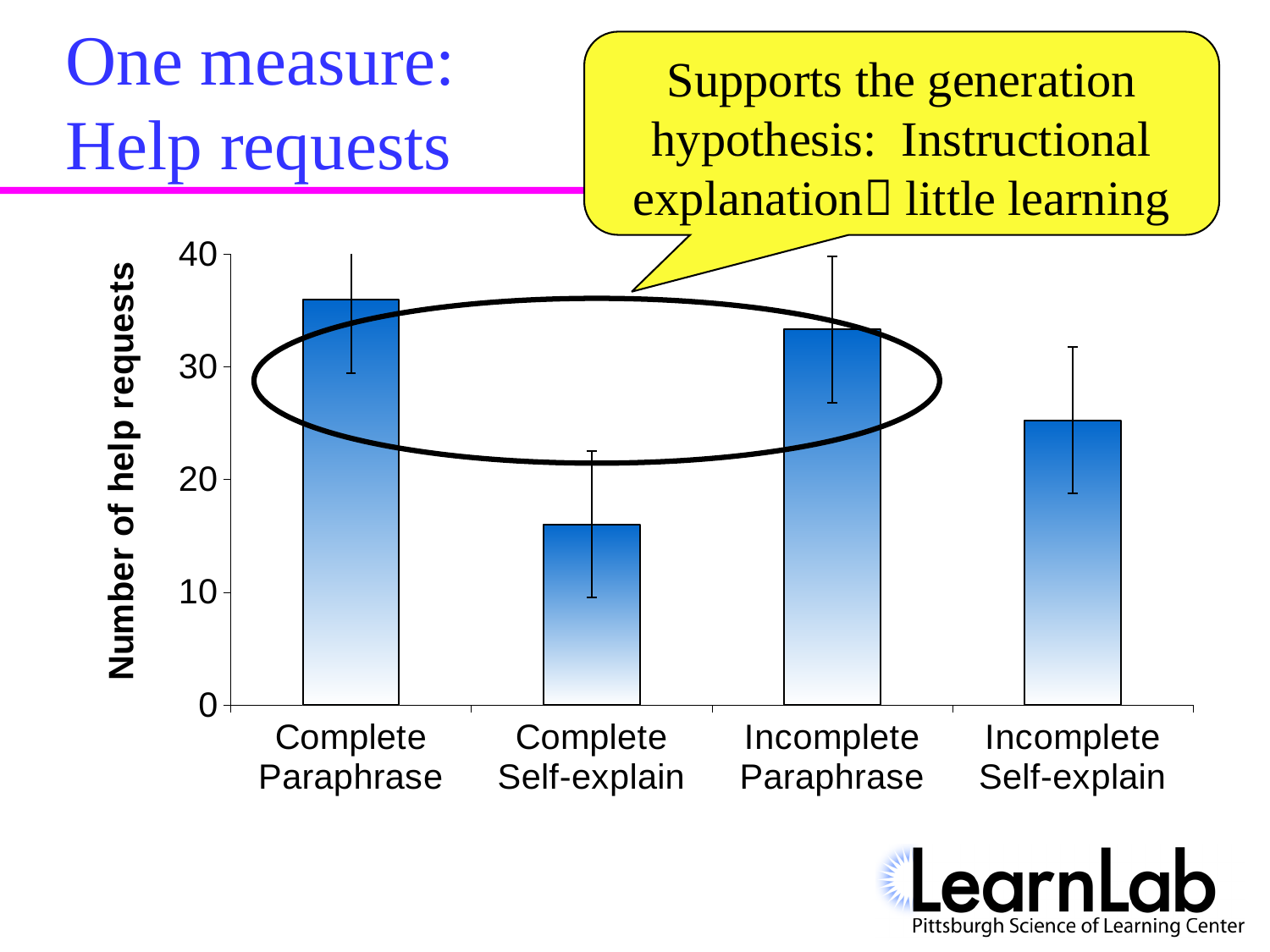
Is the value for Incomplete Self-explain greater or less than 20? greater Which category has the highest number of help requests? Complete Paraphrase Is the value for Incomplete Paraphrase greater or less than 30? greater Is the value for Complete Paraphrase greater or less than 30? greater Which has more help requests, Complete Self-explain or Incomplete Self-explain? Incomplete Self-explain How many categories are shown on the x axis of the chart? 4 What kind of chart is shown on the slide? bar chart Which has more help requests, Incomplete Paraphrase or Incomplete Self-explain? Incomplete Paraphrase What is the label on the vertical axis of the chart? Number of help requests Which category has the lowest number of help requests? Complete Self-explain